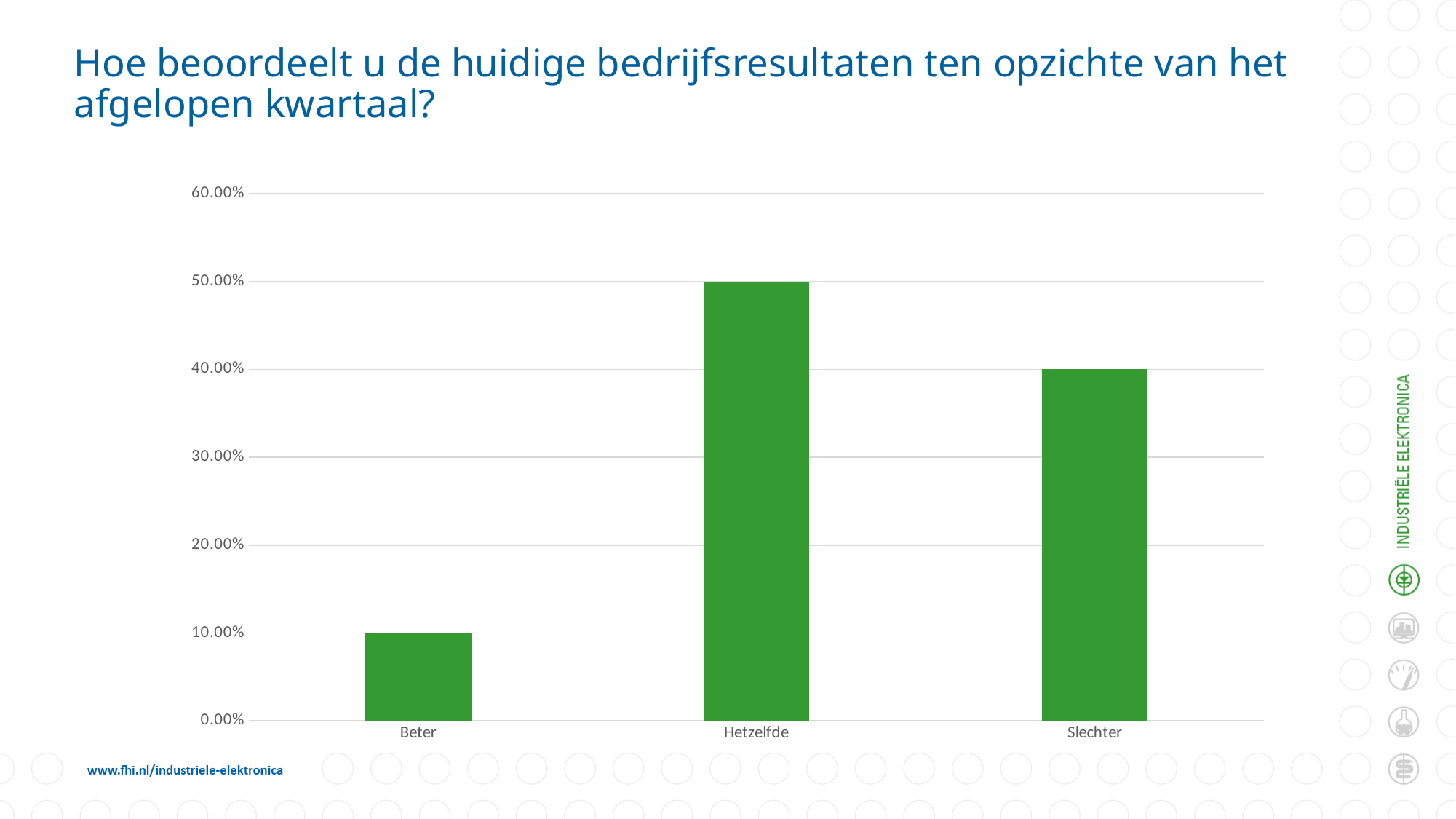
Is the value for Hetzelfde greater or less than 30.00%? greater What is the difference between the values for Hetzelfde and Slechter? 10.00% What is the highest value shown on the y axis of the chart? 60.00% How many categories are shown on the x axis of the chart? 3 Which category has the highest value? Hetzelfde Which is larger, the value for Slechter or the value for Beter? Slechter What kind of chart is shown on the slide? bar chart What is the value for Beter? 10.00% What is the value for Slechter? 40.00% What is the difference between the values for Slechter and Beter? 30.00% What is the value for Hetzelfde? 50.00% Which category has the lowest value? Beter